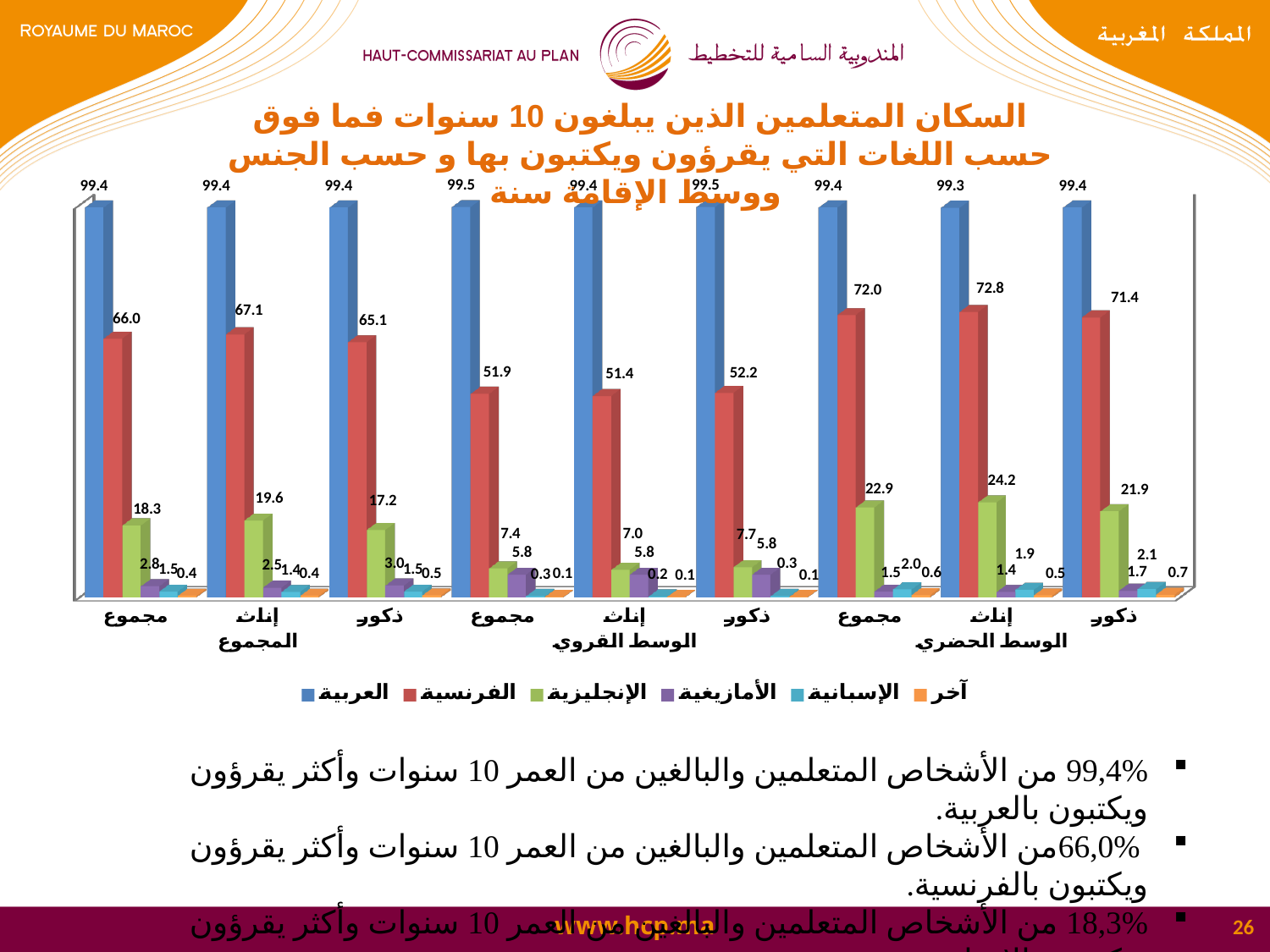
Which series has the lowest value for مجموع in the الوسط القروي group? آخر Which is larger: الإنجليزية for مجموع in الوسط الحضري or الإنجليزية for مجموع in الوسط القروي? الوسط الحضري What is the value of الإنجليزية for إناث in the الوسط الحضري group? 24.2 What is the value of الأمازيغية for مجموع in the الوسط القروي group? 5.8 What is the value of الفرنسية for مجموع in the المجموع group? 66.0 Which series has the highest value for ذكور in the الوسط الحضري group? العربية What is the difference between the الفرنسية values for إناث and ذكور in the الوسط الحضري group? 1.4 What kind of chart is shown on the slide? bar chart How many series does the legend list? 6 What is the value of العربية for إناث in the الوسط الحضري group? 99.3 How many category groups (bars clusters) are shown along the x axis? 9 Which colour represents the العربية series in the legend? blue